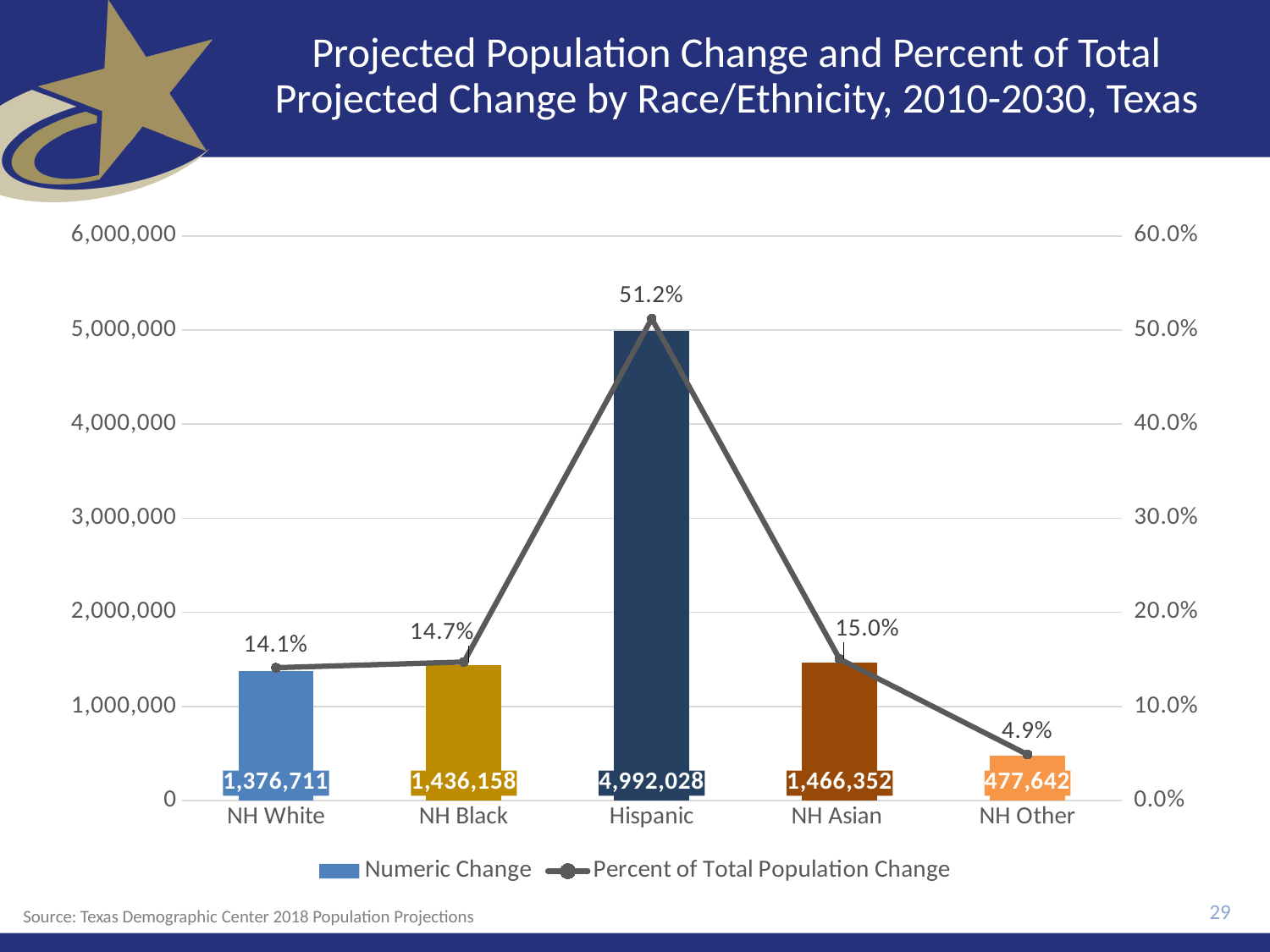
What is the difference in Numeric Change between NH Black and NH White? 59,447 Which has a larger Numeric Change, NH Asian or NH Black? NH Asian Is the Numeric Change for Hispanic greater or less than 4,000,000? greater Which race/ethnicity has the lowest Percent of Total Population Change? NH Other Which race/ethnicity has the highest Numeric Change? Hispanic How many race/ethnicity categories are shown on the x axis? 5 What kind of chart is used to show the Numeric Change series? bar chart What is the Percent of Total Population Change for NH White? 14.1% What is the Numeric Change for NH Other? 477,642 What is the Percent of Total Population Change for NH Asian? 15.0% What is the Numeric Change for Hispanic? 4,992,028 How many series does the legend list? 2